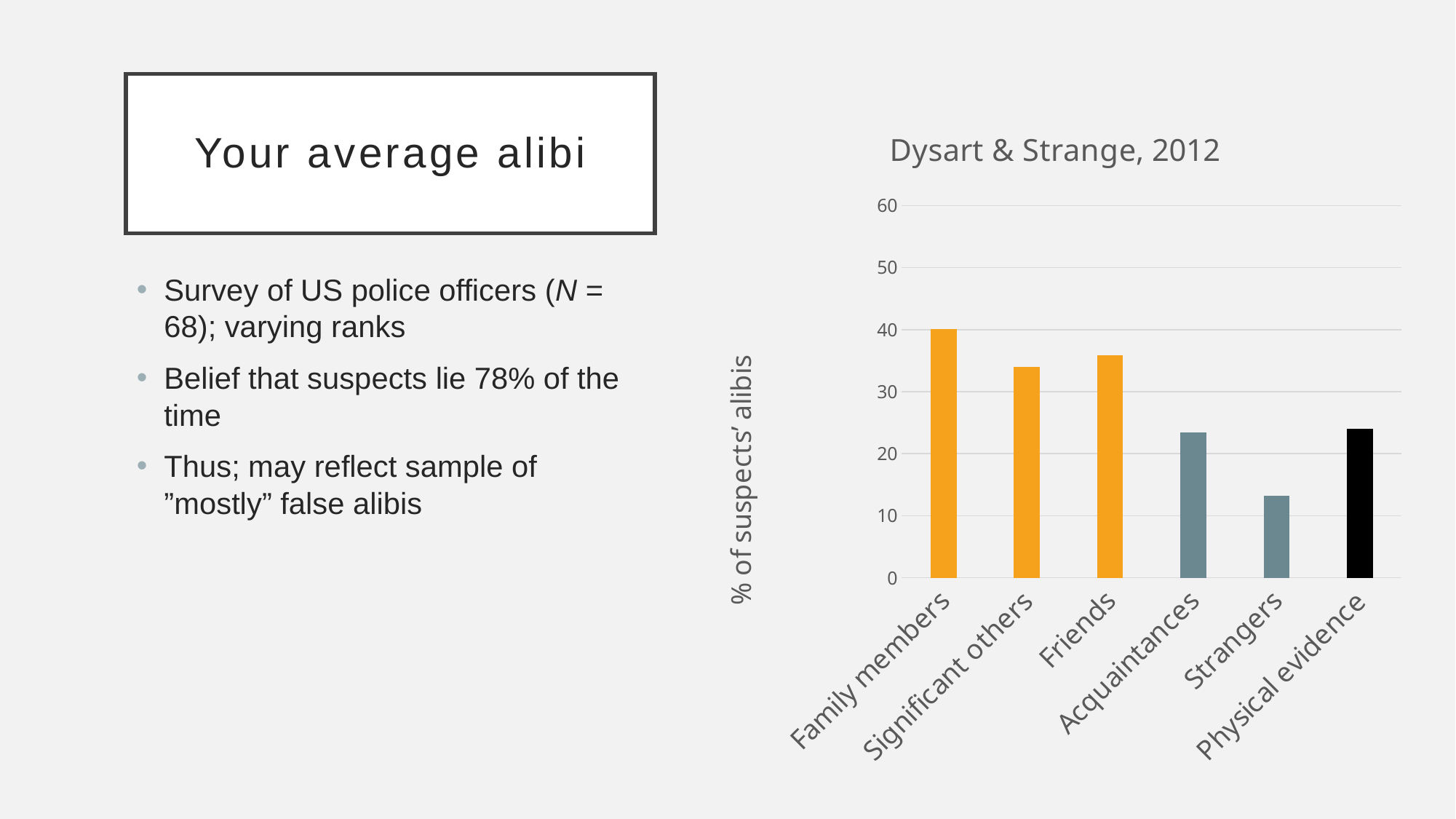
Which category has the lowest value in the chart? Strangers Which is larger, the value for Family members or the value for Acquaintances? Family members What kind of chart is shown on the slide? Bar chart Is the value for Acquaintances greater or less than 20? greater Is the value for Strangers greater or less than 20? less What is the title of the chart? Dysart & Strange, 2012 Is the value for Physical evidence greater or less than 30? less What is the label on the y axis of the chart? % of suspects' alibis Which category has the highest value in the chart? Family members How many categories are shown on the x axis of the chart? 6 Which is larger, the value for Friends or the value for Strangers? Friends